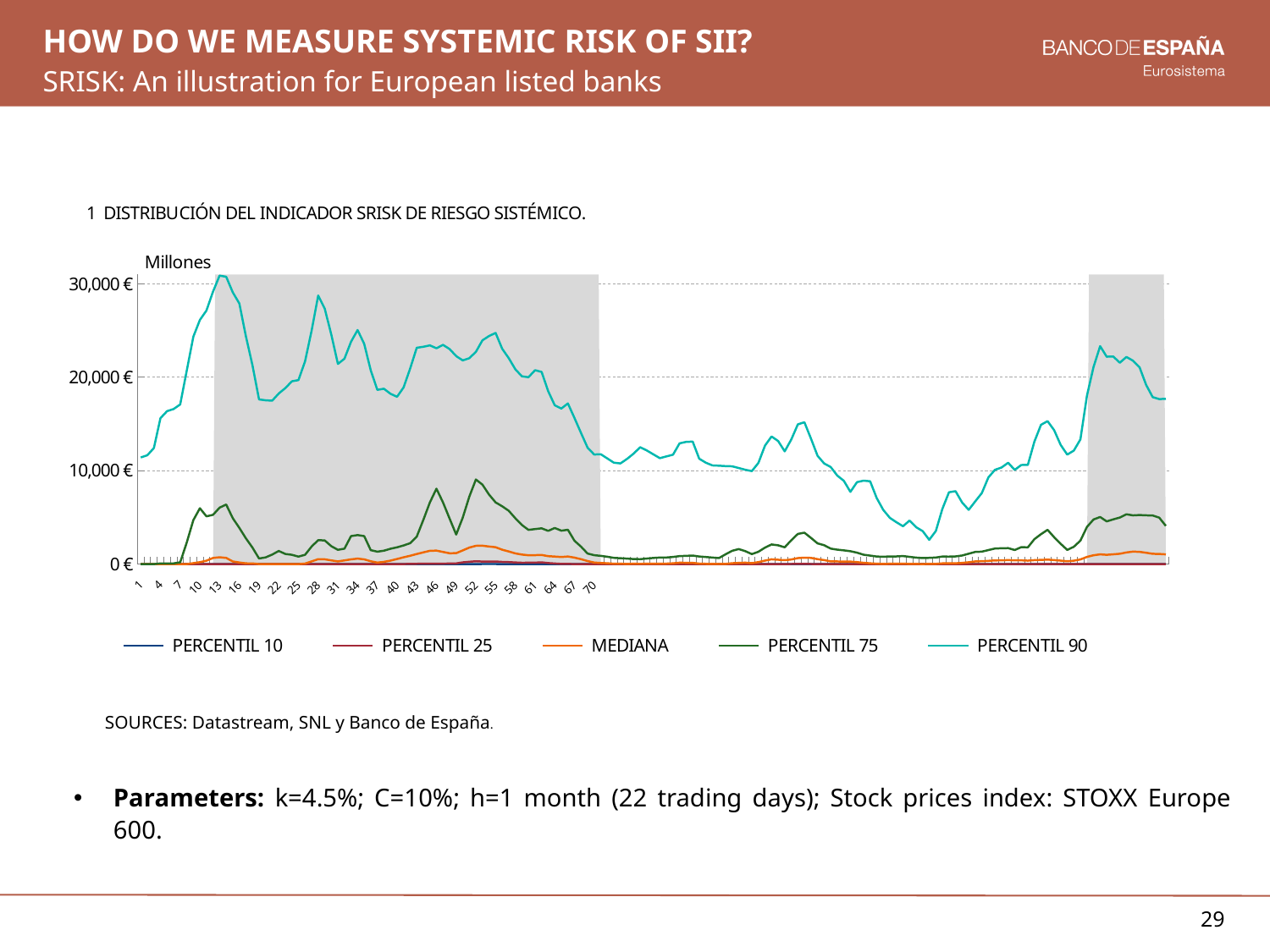
At x = 13, which is larger: PERCENTIL 90 or PERCENTIL 75? PERCENTIL 90 What kind of chart is shown on the slide? line chart Is the value of PERCENTIL 75 at x = 52 greater or less than 10,000 €? less What is the title of the chart? 1 DISTRIBUCIÓN DEL INDICADOR SRISK DE RIESGO SISTÉMICO. Does the PERCENTIL 90 line rise or fall between x = 13 and x = 19? fall Is the value of PERCENTIL 90 at x = 19 greater or less than 20,000 €? less How many series does the chart's legend list? 5 Does the PERCENTIL 90 line rise or fall between x = 1 and x = 13? rise Is the value of PERCENTIL 90 at x = 28 greater or less than 20,000 €? greater Which series reaches the highest values on the chart? PERCENTIL 90 What unit label is shown at the top of the vertical axis? Millones